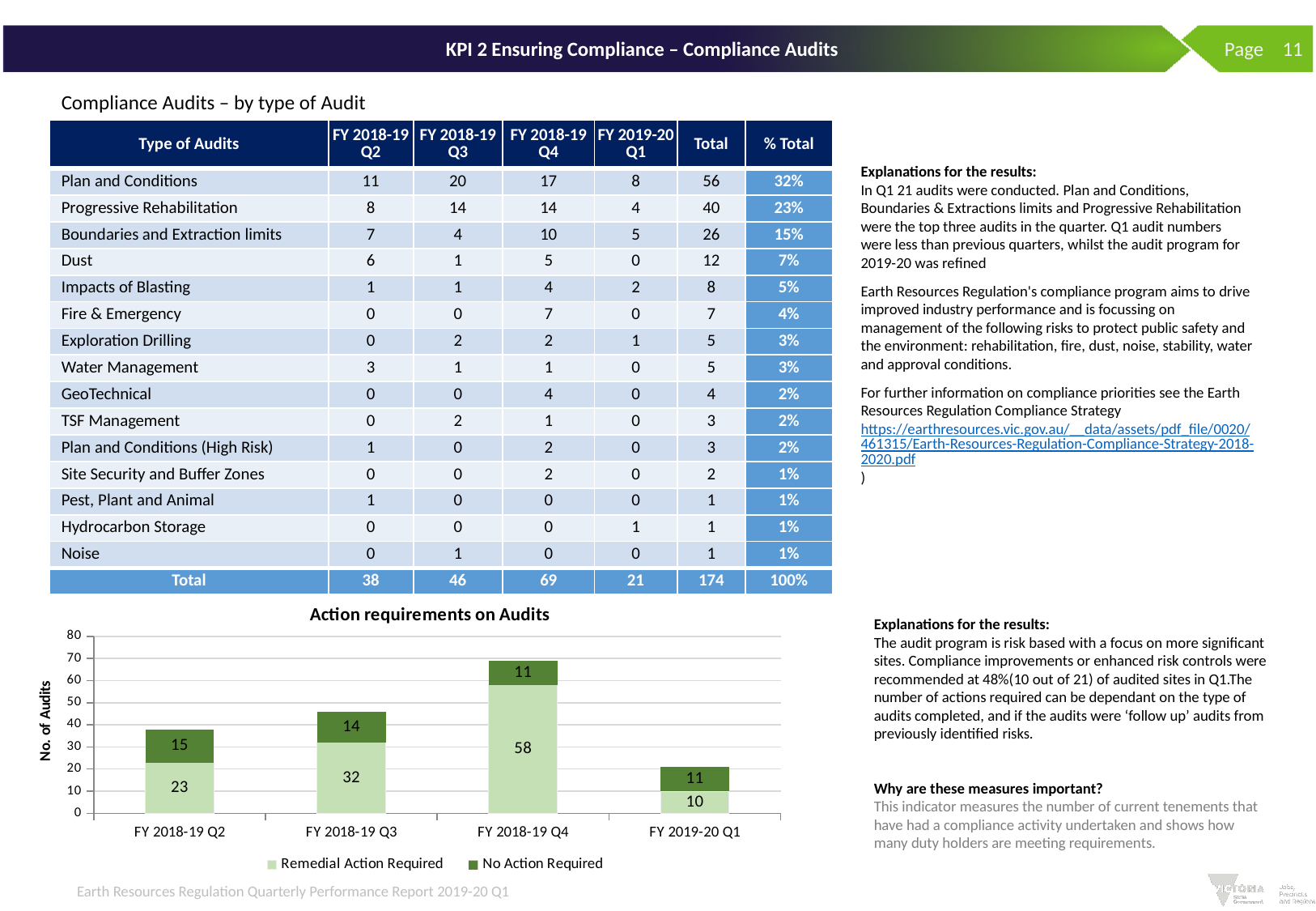
In the 'Action requirements on Audits' chart, which quarter has the highest value for Remedial Action Required? FY 2018-19 Q4 In the 'Action requirements on Audits' chart, what is the difference between Remedial Action Required in FY 2018-19 Q4 and FY 2018-19 Q3? 26 What type of chart is 'Action requirements on Audits'? Stacked bar chart In the 'Action requirements on Audits' chart, what is the total of the stacked bar for FY 2018-19 Q3? 46 What is the y-axis title of the 'Action requirements on Audits' chart? No. of Audits In the 'Action requirements on Audits' chart, which quarter has the lowest value for Remedial Action Required? FY 2019-20 Q1 How many quarters are shown on the x axis of the 'Action requirements on Audits' chart? 4 In the 'Action requirements on Audits' chart, what is the value for Remedial Action Required in FY 2018-19 Q4? 58 In the 'Action requirements on Audits' chart, is Remedial Action Required larger in FY 2018-19 Q2 or FY 2018-19 Q3? FY 2018-19 Q3 In the 'Action requirements on Audits' chart, what is the value for Remedial Action Required in FY 2019-20 Q1? 10 In the 'Action requirements on Audits' chart, what is the value for No Action Required in FY 2018-19 Q2? 15 How many series does the legend of the 'Action requirements on Audits' chart list? 2